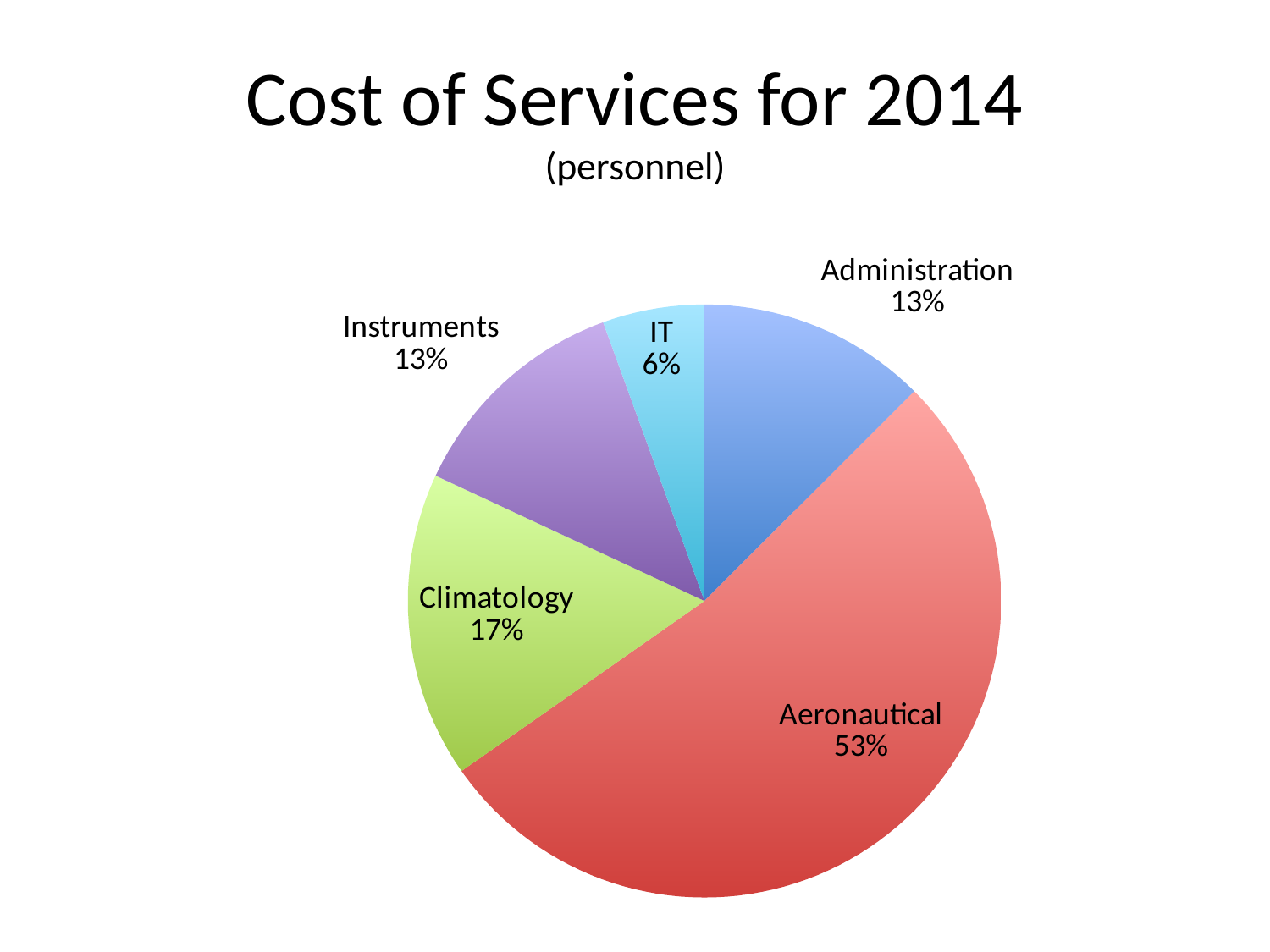
What is the difference between the Climatology and IT shares? 11% What kind of chart is shown on the slide? Pie chart What share of the pie does Climatology represent? 17% How many categories are shown in the pie chart? 5 What is the value shown for Instruments? 13% Which category has the largest slice of the pie? Aeronautical What is the title of the chart? Cost of Services for 2014 What share of the pie does Aeronautical represent? 53% What is the difference between the Aeronautical and Climatology shares? 36% Which is larger, the Climatology slice or the Administration slice? Climatology What is the value shown for IT? 6% Which category has the smallest slice of the pie? IT